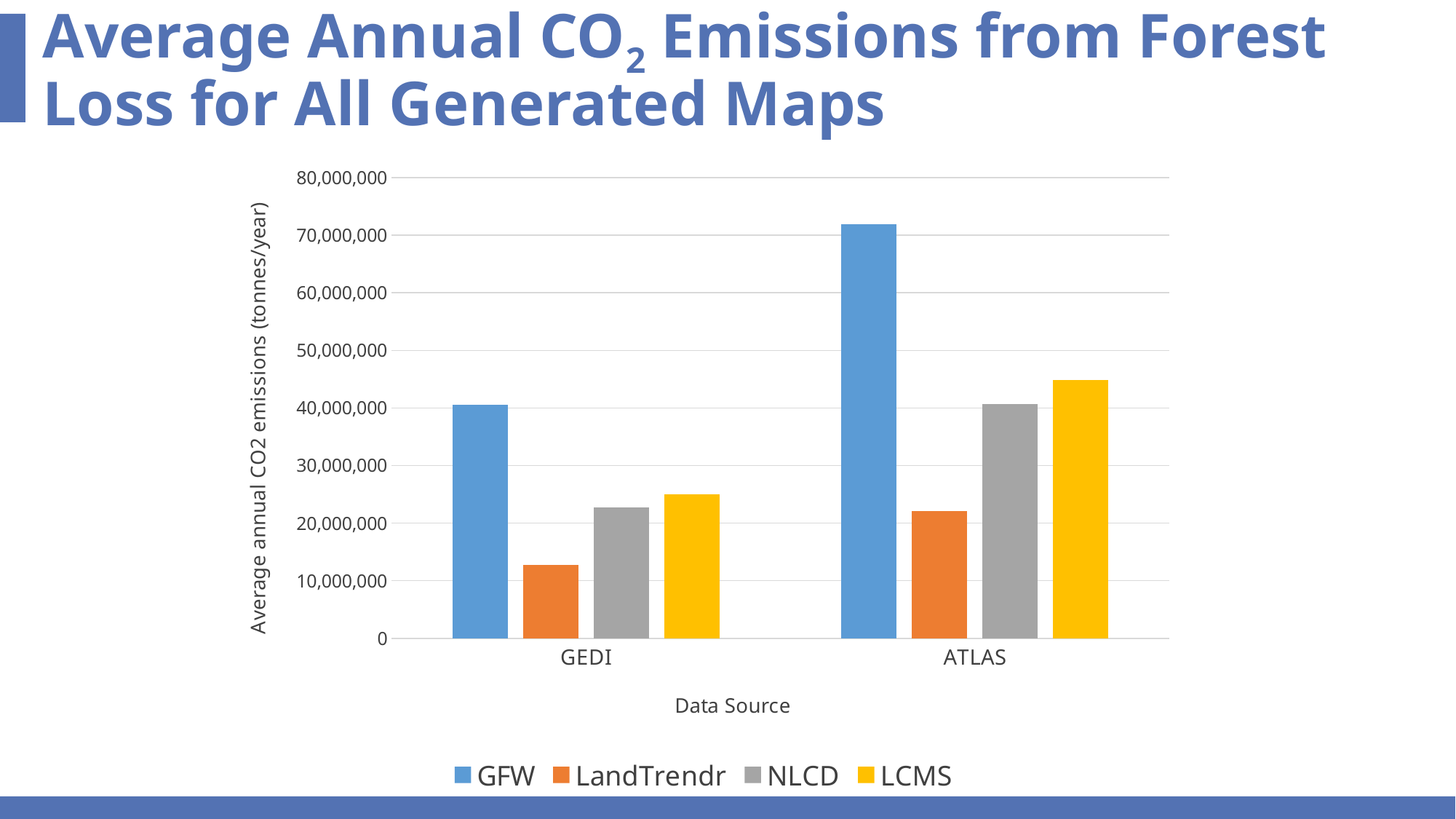
Which is larger: the LCMS value for GEDI or the LCMS value for ATLAS? ATLAS Is the LCMS value for ATLAS greater or less than 50,000,000? less How many data sources (categories) are shown on the x axis? 2 What kind of chart is shown on the slide? bar chart Which series has the lowest value for GEDI? LandTrendr Which series has the lowest value for ATLAS? LandTrendr How many series does the legend list? 4 Is the GFW value for GEDI greater or less than 30,000,000? greater Which series has the highest value for ATLAS? GFW Is the LandTrendr value for GEDI greater or less than 20,000,000? less What is the label on the x axis? Data Source